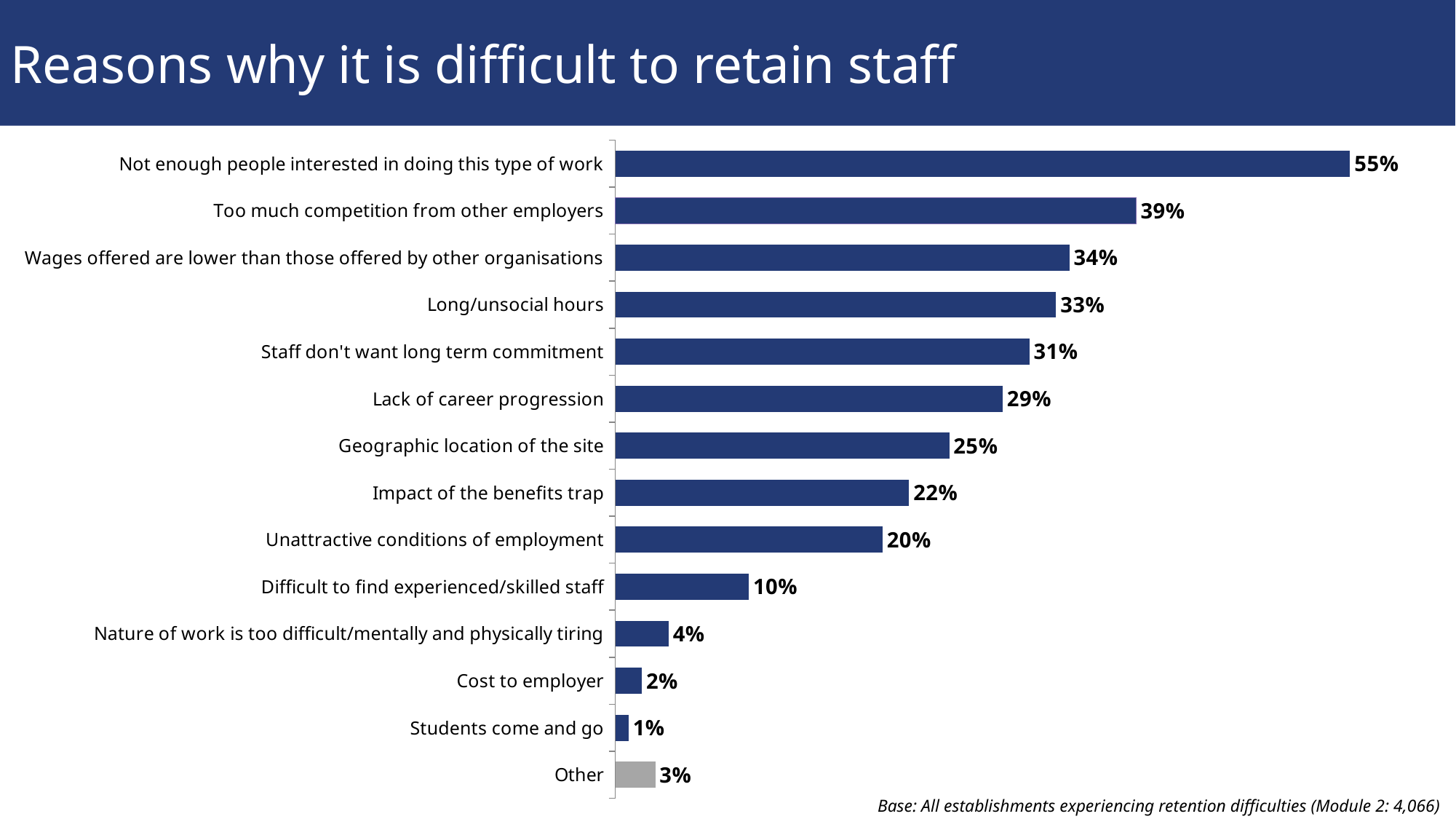
How many reasons (categories) are shown in the chart? 14 What percentage is shown for 'Cost to employer'? 2% Which is larger: 'Other' or 'Cost to employer'? Other What is the difference between 'Impact of the benefits trap' and 'Unattractive conditions of employment'? 2% Which bar is shown in a different colour (grey) from the others? Other What percentage is shown for 'Too much competition from other employers'? 39% Which is larger: 'Lack of career progression' or 'Geographic location of the site'? Lack of career progression What is the value for 'Geographic location of the site'? 25% Which reason has the lowest percentage? Students come and go Which reason has the highest percentage? Not enough people interested in doing this type of work What type of chart is shown on the slide? Bar chart What is the difference between 'Not enough people interested in doing this type of work' and 'Too much competition from other employers'? 16%